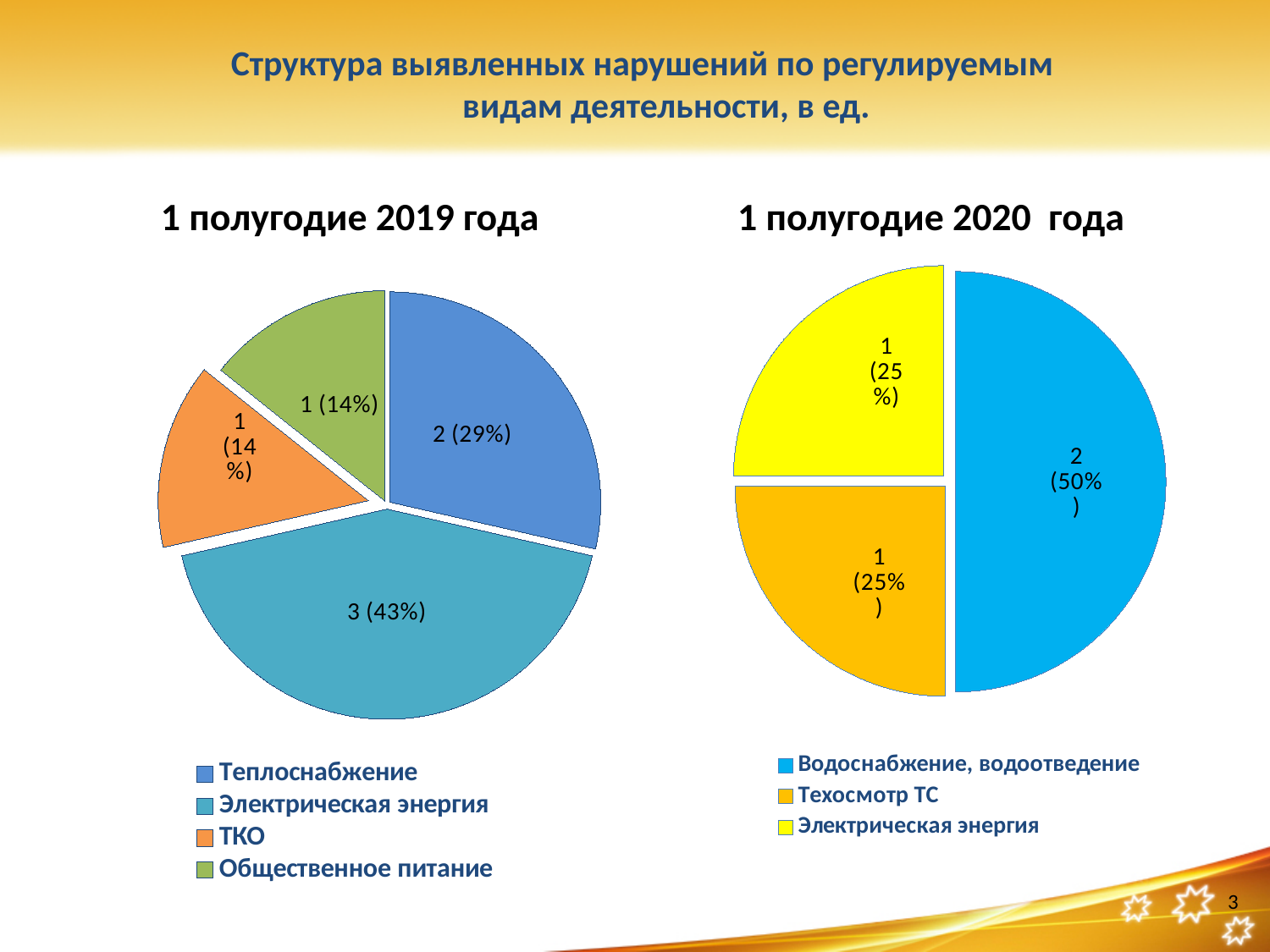
In the chart titled "1 полугодие 2019 года", what value is shown for Электрическая энергия? 3 (43%) In the chart titled "1 полугодие 2019 года", what is the difference between the values for Электрическая энергия and Теплоснабжение? 1 In the chart titled "1 полугодие 2019 года", how many categories does the legend list? 4 In the chart titled "1 полугодие 2019 года", what value is shown for Теплоснабжение? 2 (29%) In the chart titled "1 полугодие 2019 года", which category has the largest slice? Электрическая энергия In the chart titled "1 полугодие 2019 года", what share of the pie does ТКО take? 14% In the chart titled "1 полугодие 2020 года", what value is shown for Водоснабжение, водоотведение? 2 (50%) What type of chart is used on the right side of the slide, titled "1 полугодие 2020 года"? Pie chart In the chart titled "1 полугодие 2020 года", how many categories does the legend list? 3 In the chart titled "1 полугодие 2020 года", which colour represents Электрическая энергия? Yellow In the chart titled "1 полугодие 2020 года", what share of the pie does Техосмотр ТС take? 25% In the chart titled "1 полугодие 2020 года", which category has the largest slice? Водоснабжение, водоотведение